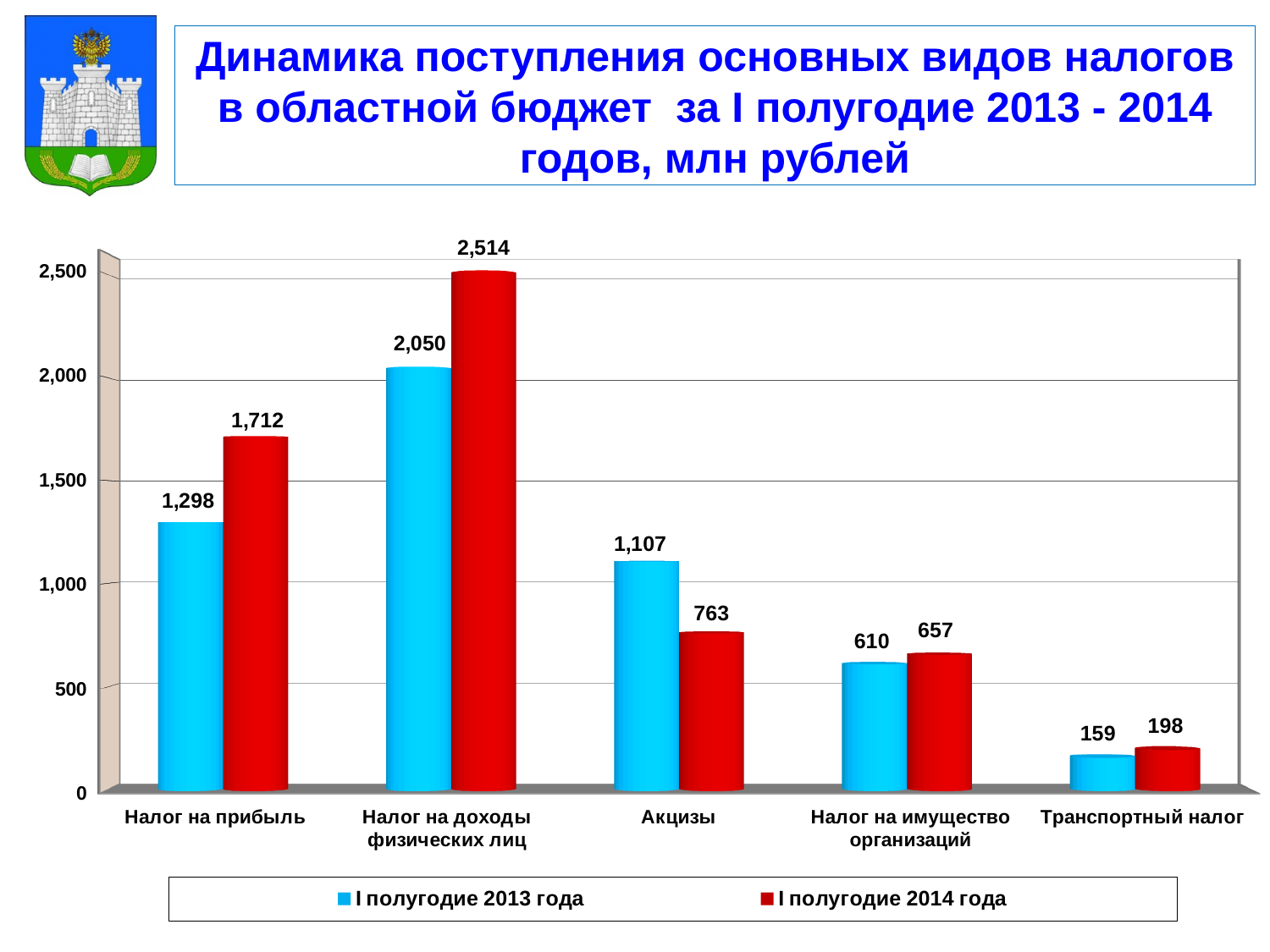
What is the value for Транспортный налог in I полугодие 2013 года? 159 Which is larger for Налог на имущество организаций: the I полугодие 2013 года value or the I полугодие 2014 года value? I полугодие 2014 года What is the value for Налог на доходы физических лиц in I полугодие 2014 года? 2,514 What is the difference between the I полугодие 2014 года and I полугодие 2013 года values for Налог на прибыль? 414 How many categories are shown on the x axis? 5 What kind of chart is shown on the slide? Bar chart What is the value for Налог на прибыль in I полугодие 2013 года? 1,298 How many series does the legend list? 2 What is the difference between the I полугодие 2013 года and I полугодие 2014 года values for Акцизы? 344 What is the value for Акцизы in I полугодие 2014 года? 763 Which category has the lowest value in I полугодие 2013 года? Транспортный налог Which category has the highest value in I полугодие 2014 года? Налог на доходы физических лиц